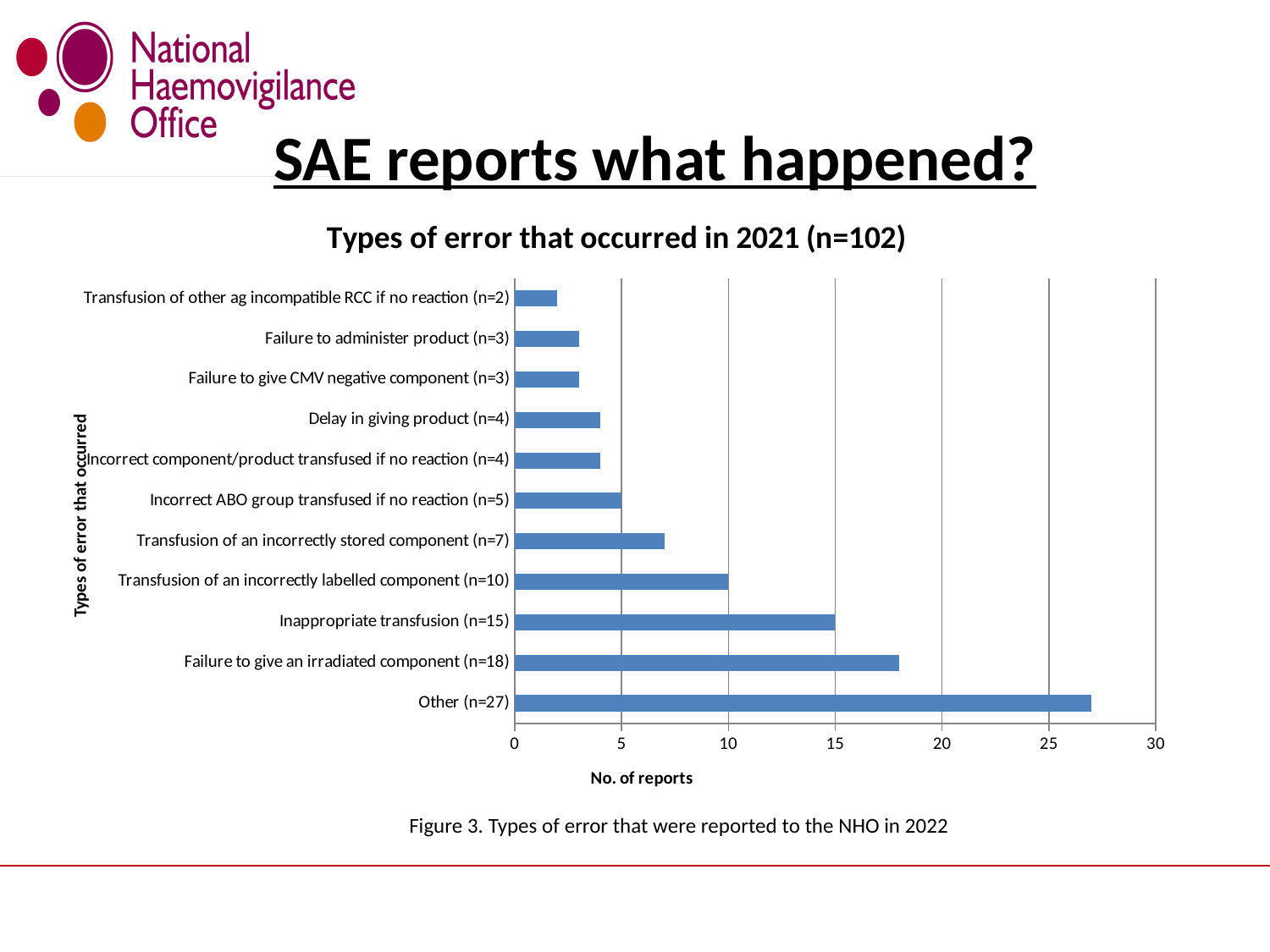
How many reports are shown for 'Inappropriate transfusion'? 15 What is the label of the horizontal axis? No. of reports Is the value for 'Other' greater or less than 25? greater How many reports are shown for 'Transfusion of an incorrectly labelled component'? 10 What kind of chart is shown on the slide? bar chart Which type of error has the lowest number of reports? Transfusion of other ag incompatible RCC if no reaction Which type of error has the highest number of reports? Other Which has more reports: 'Transfusion of an incorrectly stored component' or 'Incorrect ABO group transfused if no reaction'? Transfusion of an incorrectly stored component What is the title of the chart? Types of error that occurred in 2021 (n=102) How many reports are shown for the 'Other' category? 27 How many types of error are listed on the chart? 11 What is the difference in the number of reports between 'Failure to give an irradiated component' and 'Inappropriate transfusion'? 3